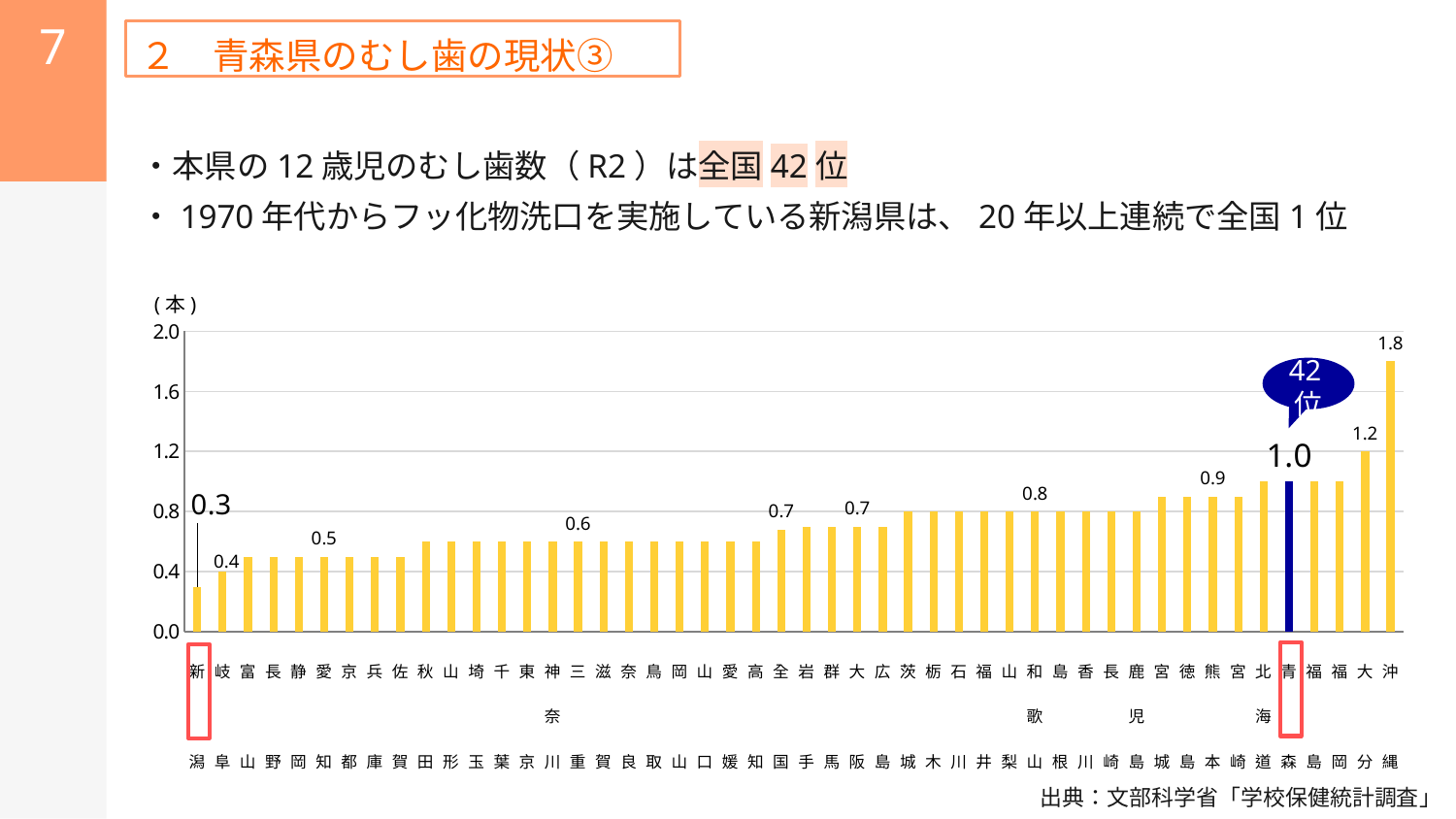
Which prefecture has the lowest value in the bar chart? 新潟 Do the values generally rise or fall from left to right along the x axis? rise What is the value for 沖縄 (Okinawa) in the bar chart? 1.8 Which has the larger value, 大分 or 青森? 大分 What is the difference between the values for 沖縄 and 青森? 0.8 Which prefecture has the highest value in the bar chart? 沖縄 Is the value for 北海道 greater or less than 1.2? less What kind of chart is shown on the slide? bar chart What is the value for 新潟 (Niigata) in the bar chart? 0.3 What is the difference between the values for 青森 and 新潟? 0.7 What is the value for 大分 (Oita) in the bar chart? 1.2 What is the value for 青森 (Aomori) in the bar chart? 1.0